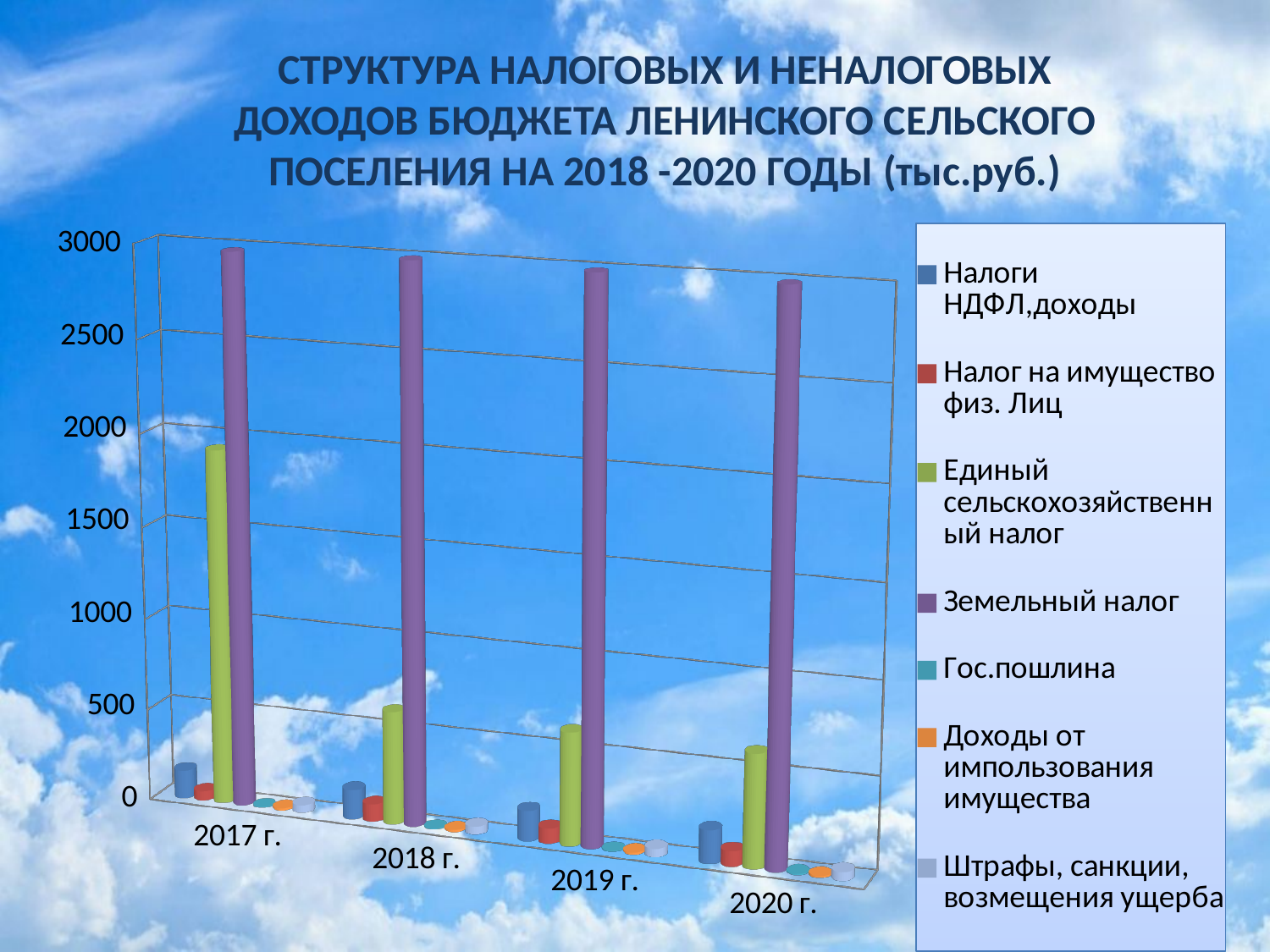
Is the value of Земельный налог for 2017 г. greater or less than 2500? greater Which is larger: Единый сельскохозяйственный налог in 2017 г. or in 2018 г.? 2017 г. How many years (categories) are shown on the x axis of the chart? 4 Which series has the highest value in 2020 г.? Земельный налог Is the value of Единый сельскохозяйственный налог for 2017 г. greater or less than 1500? greater Which series has the highest value in 2017 г.? Земельный налог What kind of chart is shown on the slide? bar chart What colour represents Земельный налог in the chart legend? purple Is the value of Единый сельскохозяйственный налог for 2018 г. greater or less than 1000? less How many series does the chart legend list? 7 Does the value of Единый сельскохозяйственный налог rise or fall from 2017 г. to 2020 г.? fall